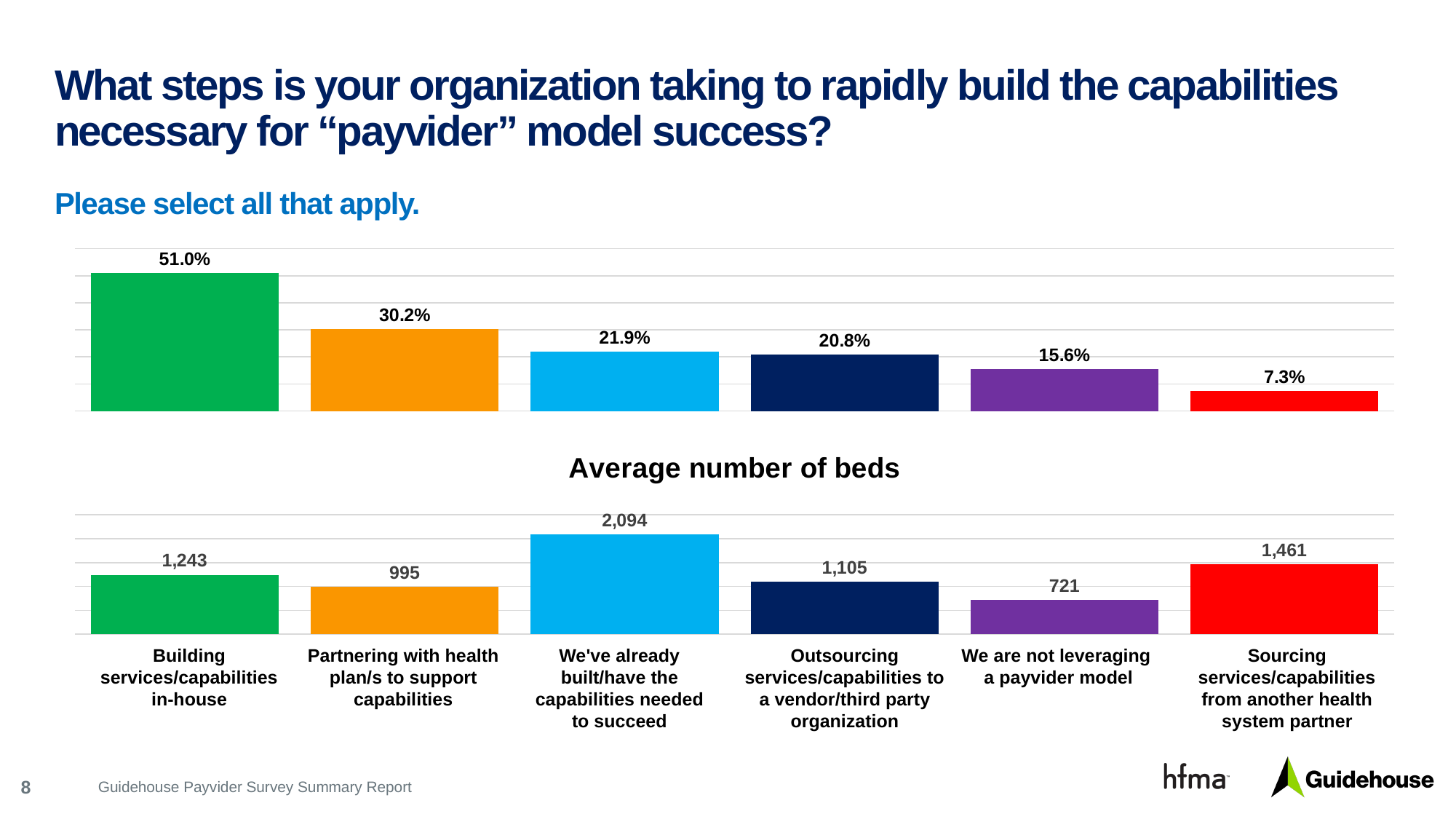
In the top chart, do the values rise or fall from left to right? Fall In the "Average number of beds" chart, which category has the highest value? We've already built/have the capabilities needed to succeed In the top chart, what is the difference in percentage points between "Building services/capabilities in-house" and "Partnering with health plan/s to support capabilities"? 20.8 percentage points In the "Average number of beds" chart, which category has the lowest value? We are not leveraging a payvider model In the top chart, what percentage is shown for "Building services/capabilities in-house"? 51.0% In the top chart, which category has the lowest percentage? Sourcing services/capabilities from another health system partner In the "Average number of beds" chart, what is the value for "Outsourcing services/capabilities to a vendor/third party organization"? 1,105 In the "Average number of beds" chart, which is larger: the value for "Building services/capabilities in-house" or for "Sourcing services/capabilities from another health system partner"? Sourcing services/capabilities from another health system partner In the "Average number of beds" chart, what is the difference between the values for "We've already built/have the capabilities needed to succeed" and "Partnering with health plan/s to support capabilities"? 1,099 How many categories are shown in the "Average number of beds" chart? 6 In the "Average number of beds" chart, what is the value for "We've already built/have the capabilities needed to succeed"? 2,094 In the top chart, what percentage is shown for "We are not leveraging a payvider model"? 15.6%